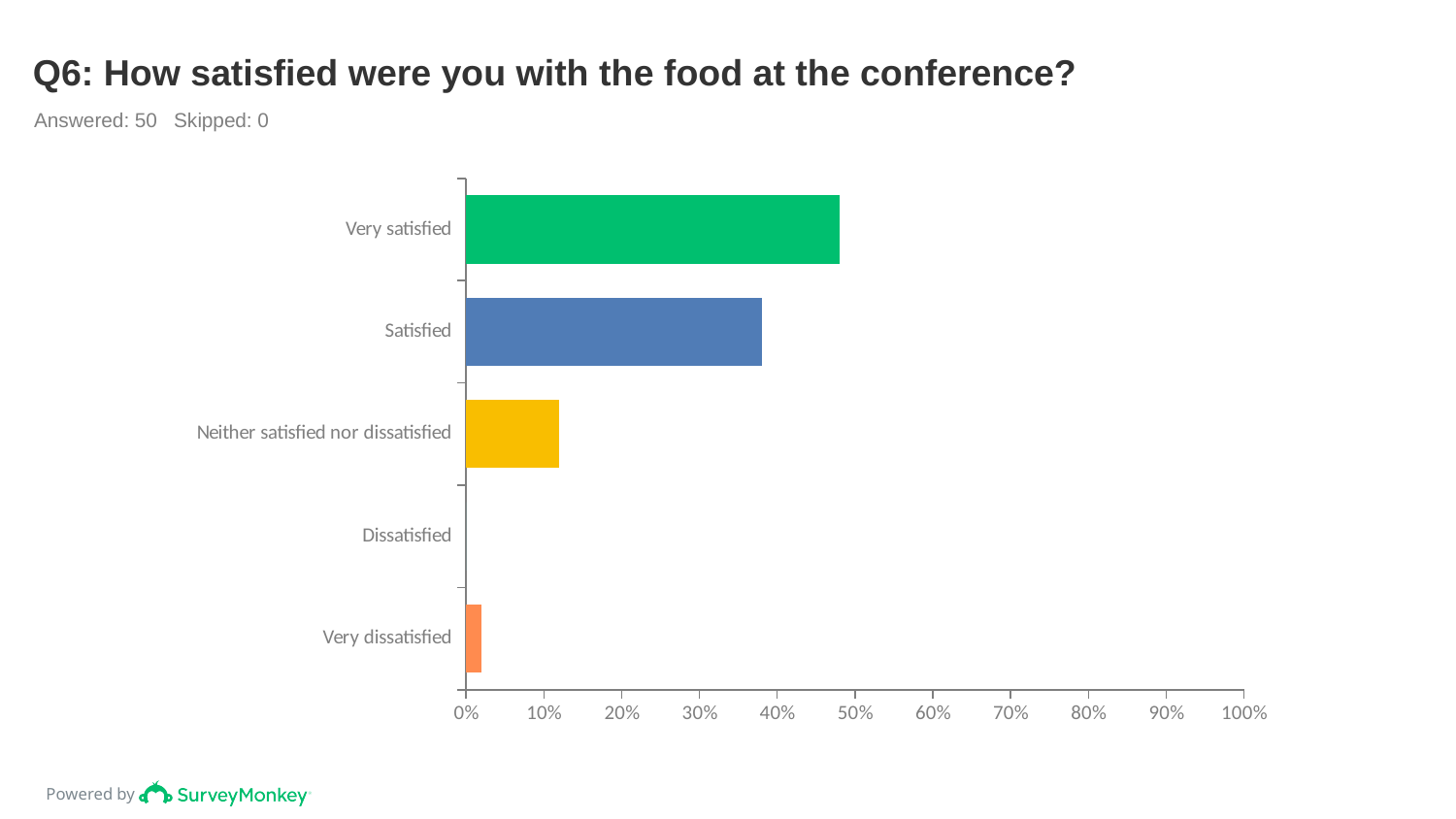
Is the value for Satisfied greater or less than 40%? less What kind of chart is shown on the slide? bar chart What is the title of the chart? Q6: How satisfied were you with the food at the conference? Is the value for Neither satisfied nor dissatisfied greater or less than 10%? greater Which category has the highest value? Very satisfied Is the value for Very dissatisfied greater or less than 10%? less How many respondents answered this question according to the slide? 50 Which is larger, the value for Very satisfied or the value for Satisfied? Very satisfied How many response categories are shown on the chart? 5 Which is larger, the value for Satisfied or the value for Neither satisfied nor dissatisfied? Satisfied Which category has the lowest value? Dissatisfied